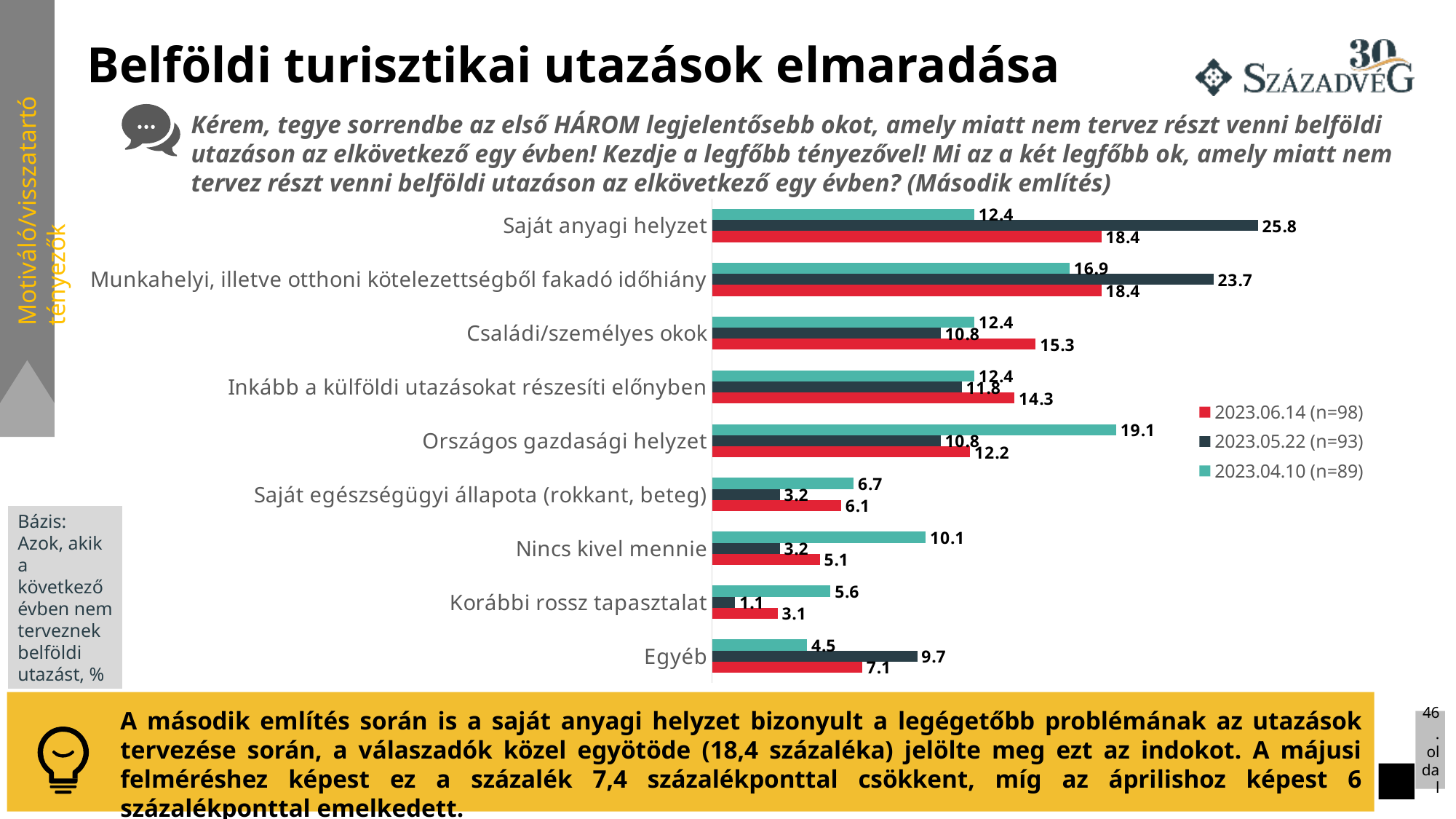
Which category has the highest value in the 2023.05.22 (n=93) series? Saját anyagi helyzet Which series is shown in red in the legend? 2023.06.14 (n=98) Which category has the lowest value in the 2023.05.22 (n=93) series? Korábbi rossz tapasztalat What is the value for 'Saját anyagi helyzet' in the 2023.05.22 (n=93) series? 25.8 What is the value for 'Országos gazdasági helyzet' in the 2023.04.10 (n=89) series? 19.1 Which category has the highest value in the 2023.04.10 (n=89) series? Országos gazdasági helyzet For 'Egyéb', which series has the larger value: 2023.05.22 (n=93) or 2023.06.14 (n=98)? 2023.05.22 (n=93) What kind of chart is shown on the slide? bar chart What is the value for 'Korábbi rossz tapasztalat' in the 2023.06.14 (n=98) series? 3.1 How many categories (reasons) are shown in the chart? 9 What is the difference between the 2023.05.22 (n=93) and 2023.06.14 (n=98) values for 'Saját anyagi helyzet'? 7.4 How many series does the legend list? 3